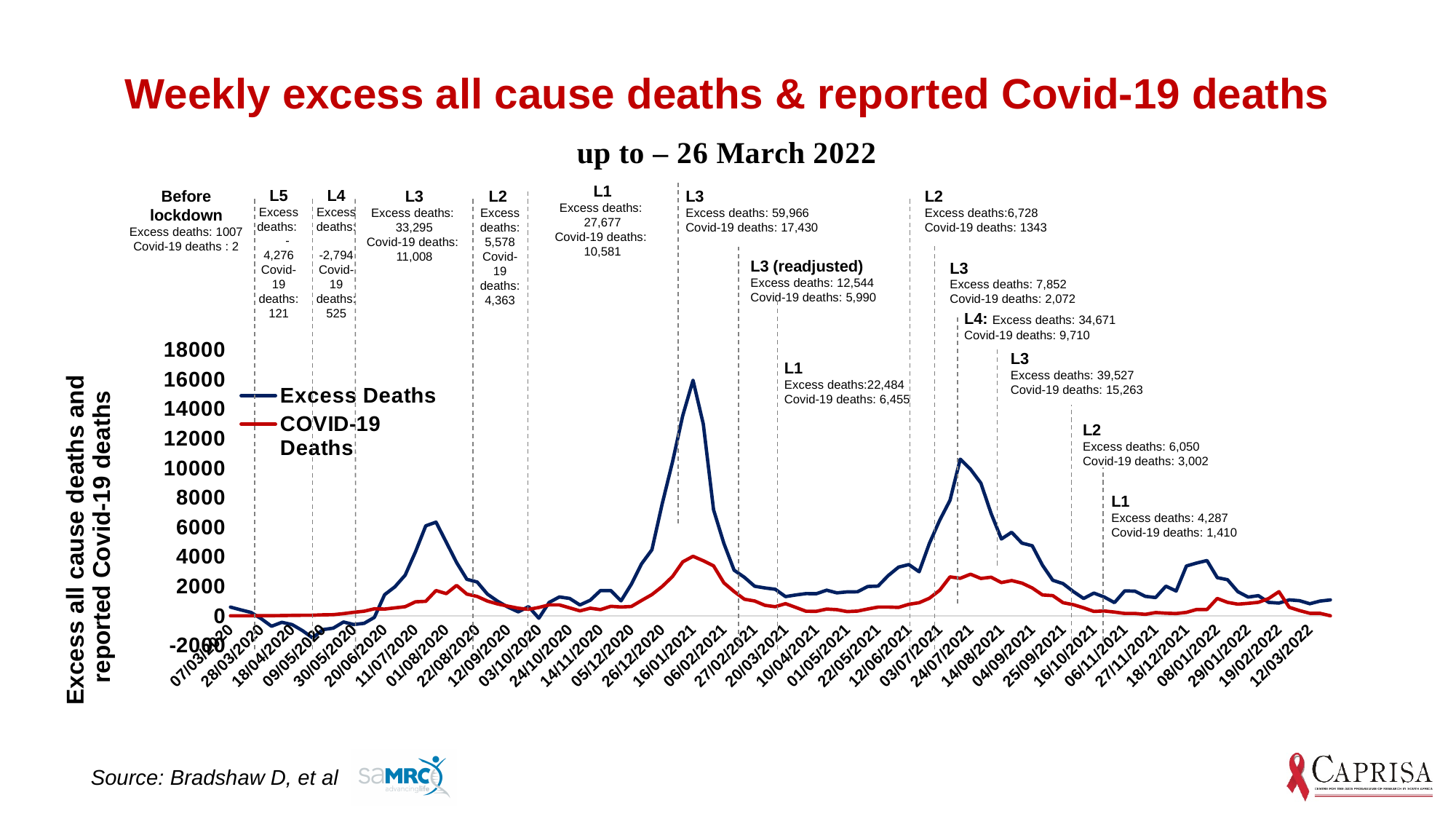
Is the peak value of the Excess Deaths line around 16/01/2021 greater or less than 14000? greater What is the highest excess deaths figure given in any of the lockdown-period annotations on the chart? 59,966 In the L3 period annotated with 59,966 excess deaths, what is the difference between excess deaths and Covid-19 deaths (17,430)? 42,536 Is the peak of the Excess Deaths line around 24/07/2021 greater or less than 8000? greater What kind of chart is shown on the slide? line chart Do the Excess Deaths values rise or fall between 16/01/2021 and 27/02/2021? fall Is the peak value of the COVID-19 Deaths line around 16/01/2021 greater or less than 6000? less According to the annotation, how many excess deaths were recorded in the 'Before lockdown' period? 1007 At the peak around 16/01/2021, which series is higher, Excess Deaths or COVID-19 Deaths? Excess Deaths How many series does the chart's legend list? 2 What are the two series named in the chart's legend? Excess Deaths and COVID-19 Deaths According to the annotation for the L1 period in late 2020, how many Covid-19 deaths were reported? 10,581